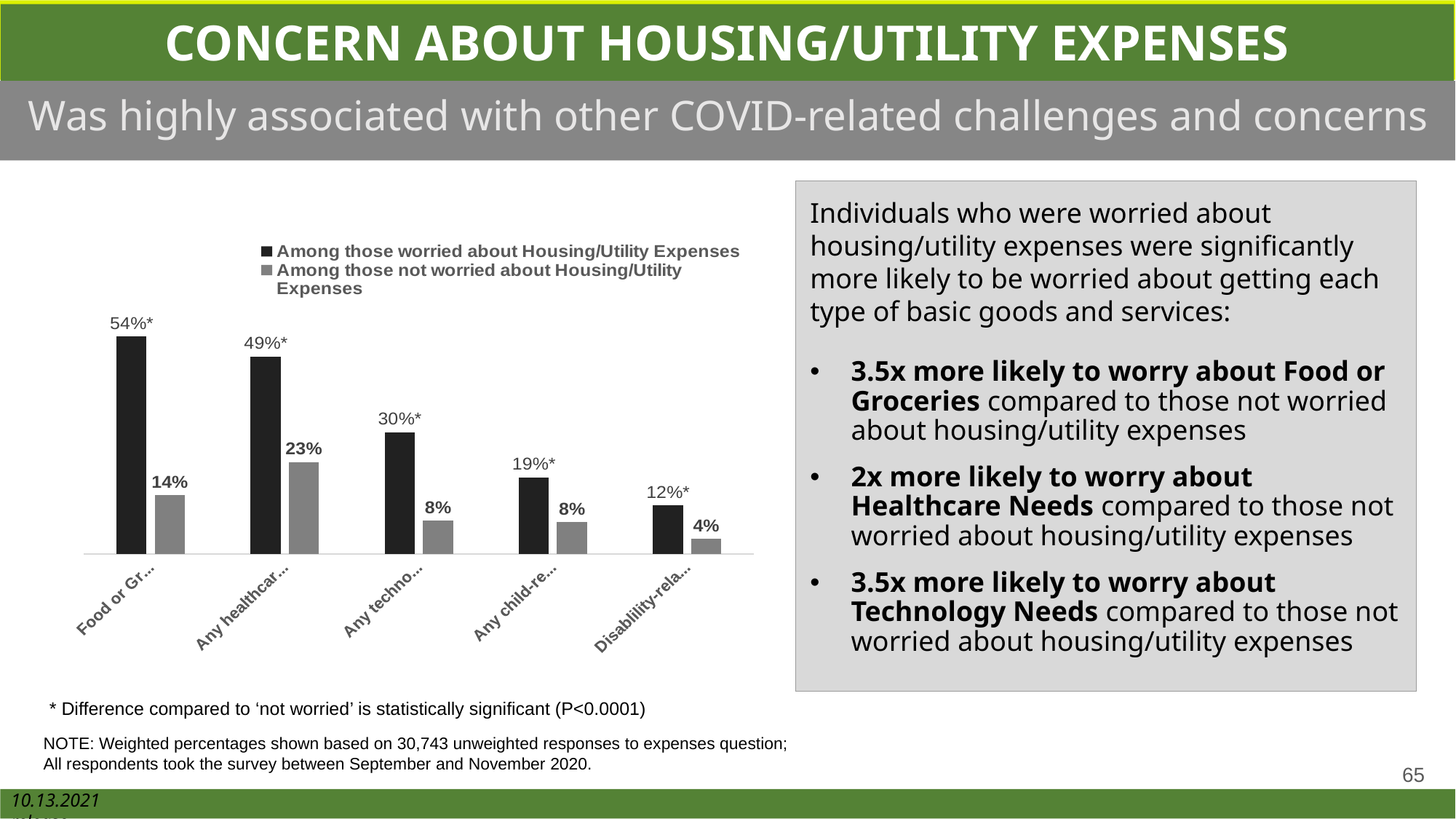
Which category has the highest value among those worried about Housing/Utility Expenses? Food or Groceries Do the values for those worried about Housing/Utility Expenses rise or fall from left to right across the categories? fall What is the value for Disability-related needs among those not worried about Housing/Utility Expenses? 4% Which category has the lowest value among those not worried about Housing/Utility Expenses? Disability-related Among those not worried about Housing/Utility Expenses, which is larger: Food or Groceries or Any healthcare needs? Any healthcare needs What is the value for Food or Groceries among those worried about Housing/Utility Expenses? 54% How many categories are shown on the x axis of the chart? 5 How many series does the chart's legend list? 2 For Food or Groceries, what is the difference between the worried and not worried values? 40 percentage points What is the value for Any healthcare needs among those not worried about Housing/Utility Expenses? 23% What is the value for Any technology needs among those worried about Housing/Utility Expenses? 30% For Any healthcare needs, what is the difference between the worried and not worried values? 26 percentage points